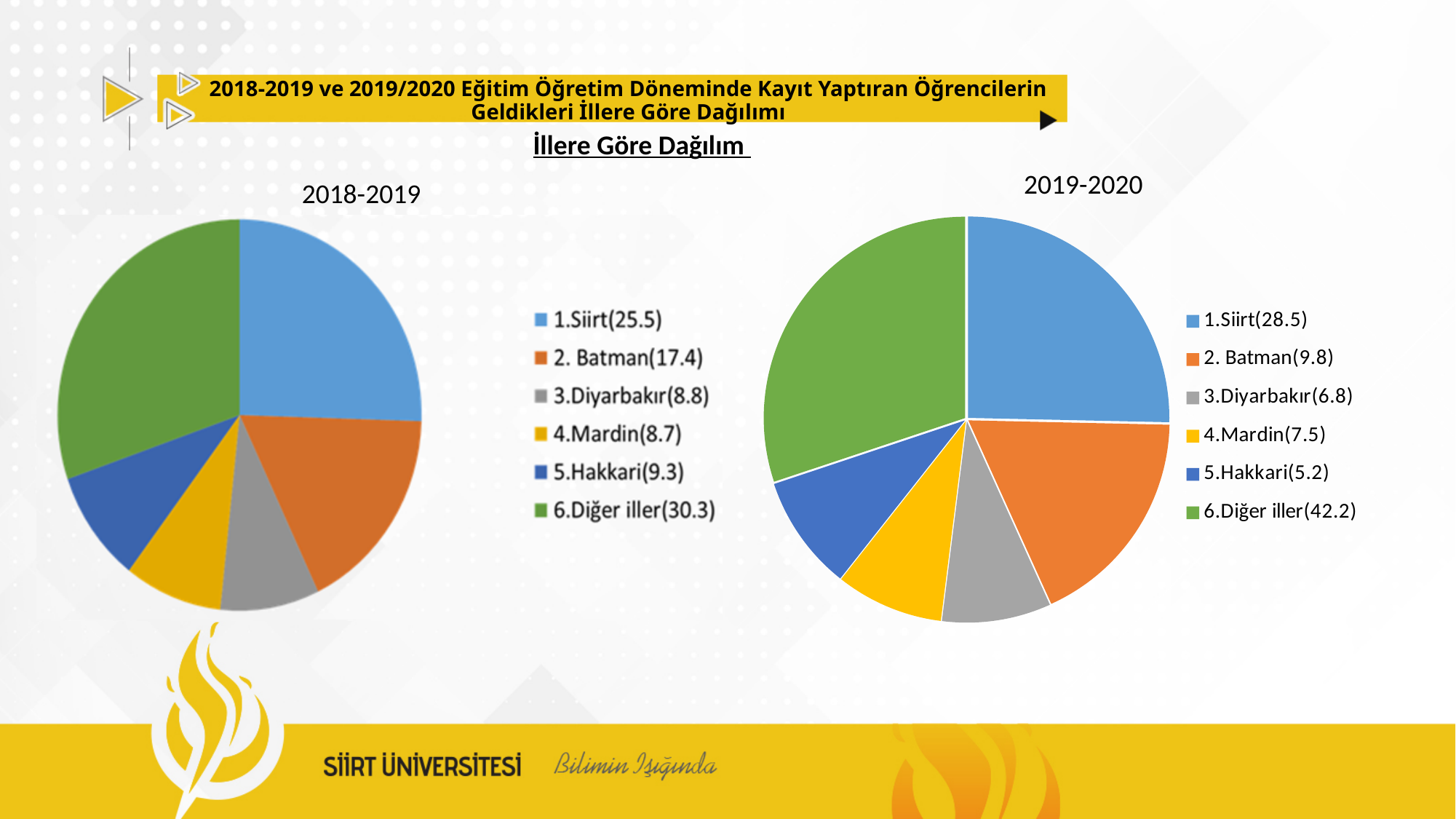
In the 2019-2020 pie chart, what is the difference between the values for Diğer iller and Siirt? 13.7 In the 2018-2019 pie chart, what colour is the slice for Mardin? Yellow Which is larger: the value for Batman in the 2018-2019 chart or in the 2019-2020 chart? 2018-2019 How many categories does the 2018-2019 pie chart have? 6 In the 2019-2020 pie chart, which is larger, Mardin or Diyarbakır? Mardin What type of chart is used for the 2019-2020 data? Pie chart In the 2019-2020 pie chart, which category has the smallest slice? Hakkari In the 2018-2019 pie chart, which category has the largest slice? Diğer iller In the 2018-2019 pie chart, what is the difference between the values for Siirt and Batman? 8.1 In the 2018-2019 pie chart, what value is shown for Siirt? 25.5 In the 2019-2020 pie chart, what value is shown for Diğer iller? 42.2 In the 2019-2020 pie chart, what value is shown for Hakkari? 5.2